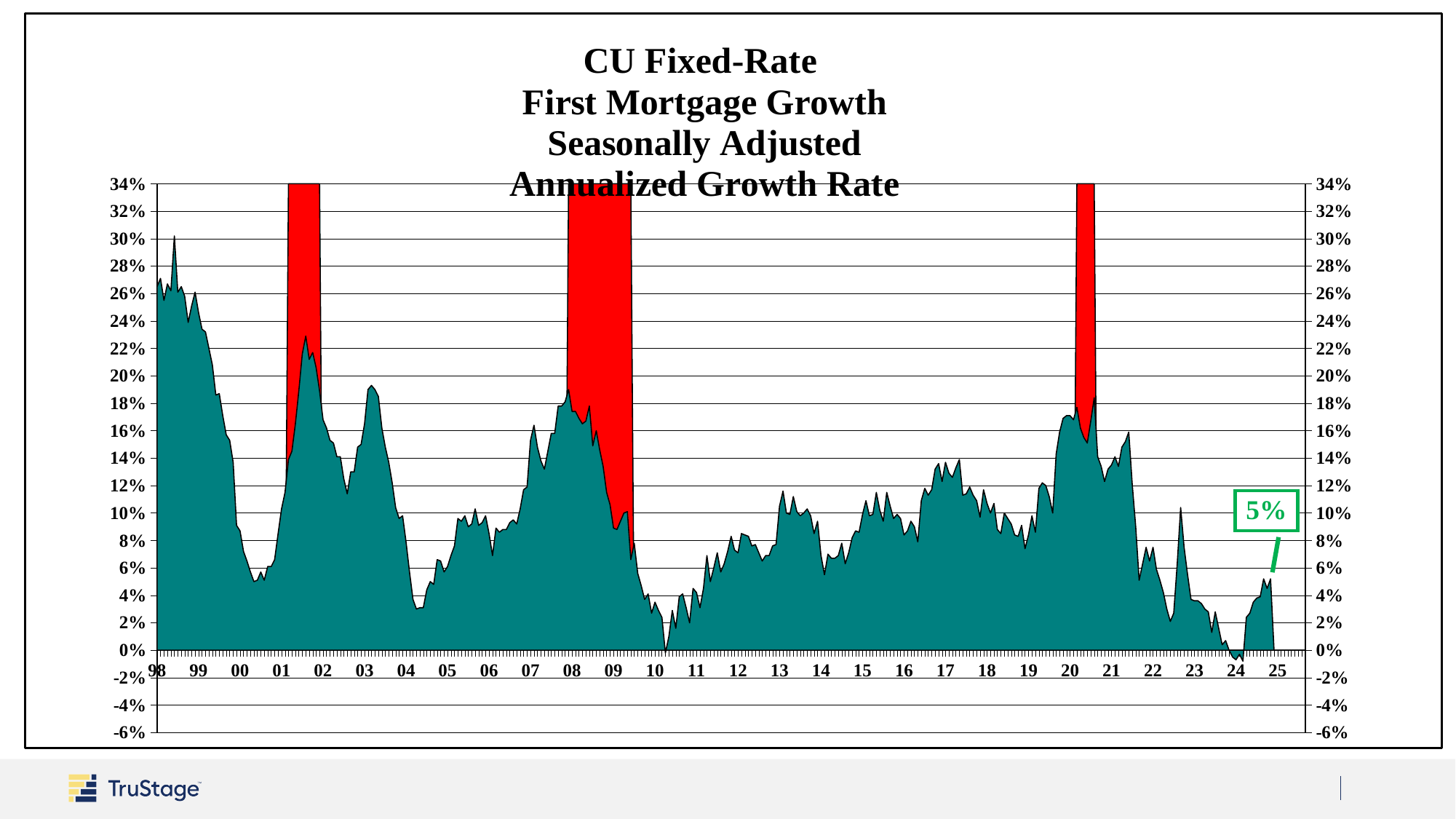
What is the highest value shown on the y axis? 34% What kind of chart is shown on the slide? area chart What is the lowest value shown on the y axis? -6% Which is higher: the peak growth rate around 99 or the peak around 02? the peak around 99 What is the most recent value called out on the chart, near 25? 5% How many year labels are shown on the x axis? 28 How many red shaded bands appear on the chart? 3 Is the growth rate at 24 greater or less than 2%? less Is the peak growth rate around 99 greater or less than 26%? greater Between 22 and 24, does the growth rate generally rise or fall? fall Is the growth rate at 10 greater or less than 4%? less What is the title of the chart? CU Fixed-Rate First Mortgage Growth Seasonally Adjusted Annualized Growth Rate